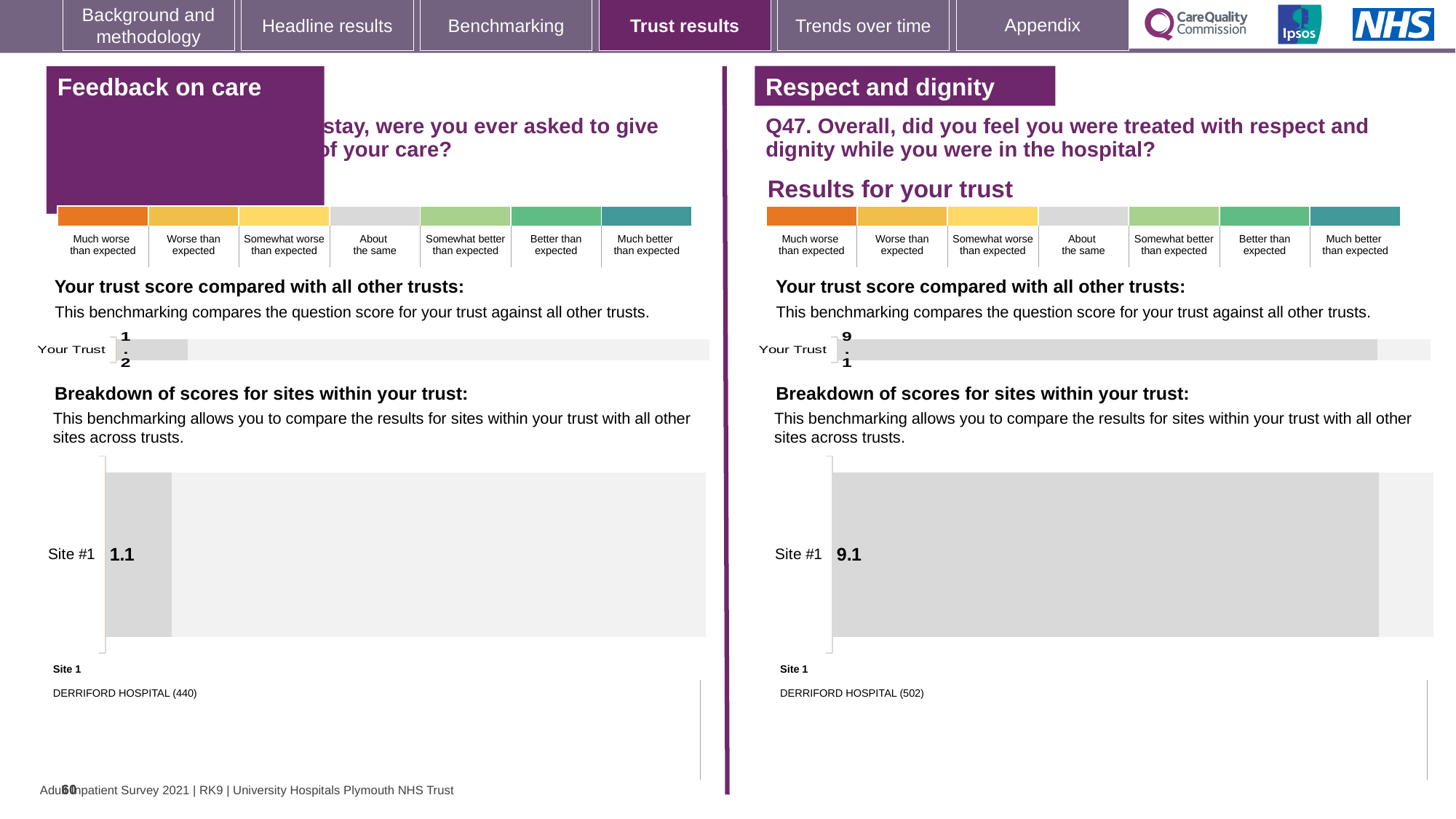
On the 'Feedback on care' panel, what is the difference between the Your Trust score and the Site #1 score? 0.1 What kind of chart is used to show the Site #1 score on the 'Respect and dignity' panel? Bar chart Which site name is listed under Site 1 on the 'Feedback on care' panel? DERRIFORD HOSPITAL (440) On the 'Respect and dignity' panel, what is the difference between the Your Trust score and the Site #1 score? 0 On the 'Respect and dignity' panel, what is the score shown for Your Trust in the 'Your trust score compared with all other trusts' chart? 9.1 On the 'Feedback on care' panel, what score is shown for Site #1 in the breakdown of scores for sites chart? 1.1 Which panel shows the higher Your Trust score: 'Feedback on care' or 'Respect and dignity'? Respect and dignity Which site name is listed under Site 1 on the 'Respect and dignity' panel? DERRIFORD HOSPITAL (502) On the 'Feedback on care' panel, which is larger: the Your Trust score or the Site #1 score? Your Trust On the 'Feedback on care' panel, what is the score shown for Your Trust in the 'Your trust score compared with all other trusts' chart? 1.2 On the 'Respect and dignity' panel, what score is shown for Site #1 in the breakdown of scores for sites chart? 9.1 How many sites are plotted in the breakdown of scores chart on the 'Feedback on care' panel? 1